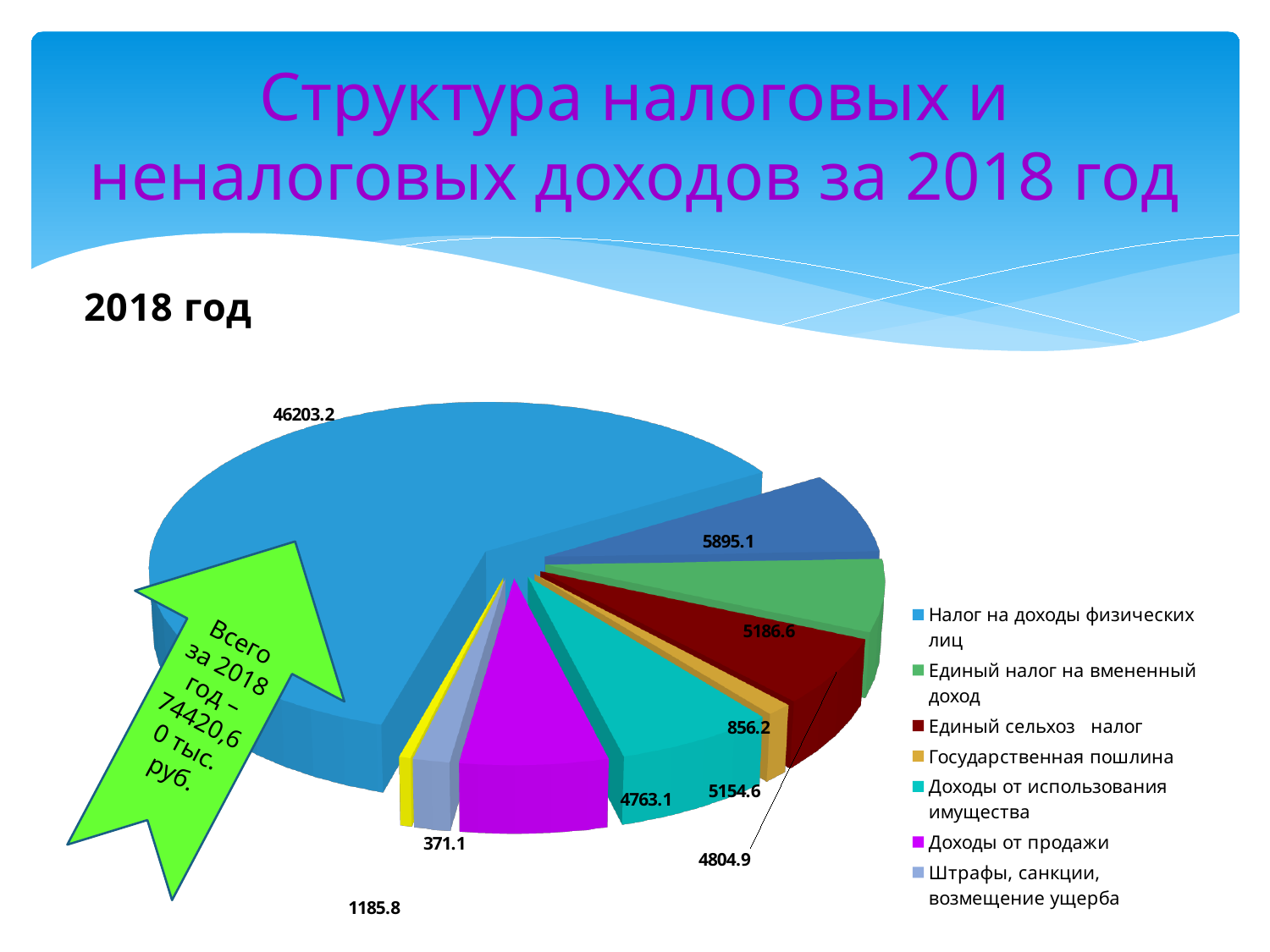
What kind of chart is shown on the slide? pie chart What is the difference between the slices labelled 5186.6 and 5154.6? 32 Which is larger, the slice labelled 4804.9 or the slice labelled 4763.1? 4804.9 What is the title of the slide containing the pie chart? Структура налоговых и неналоговых доходов за 2018 год Which is larger, the slice labelled 5895.1 or the slice labelled 5186.6? 5895.1 What is the difference between the largest slice (46203.2) and the slice labelled 5895.1? 40308.1 What is the value of the largest slice in the pie chart? 46203.2 According to the green arrow, what is the total for 2018? 74420,60 тыс. руб. What is the value for Налог на доходы физических лиц? 46203.2 What is the value of the smallest slice in the pie chart? 371.1 How many data labels are printed on the pie chart? 9 How many entries does the legend list? 7